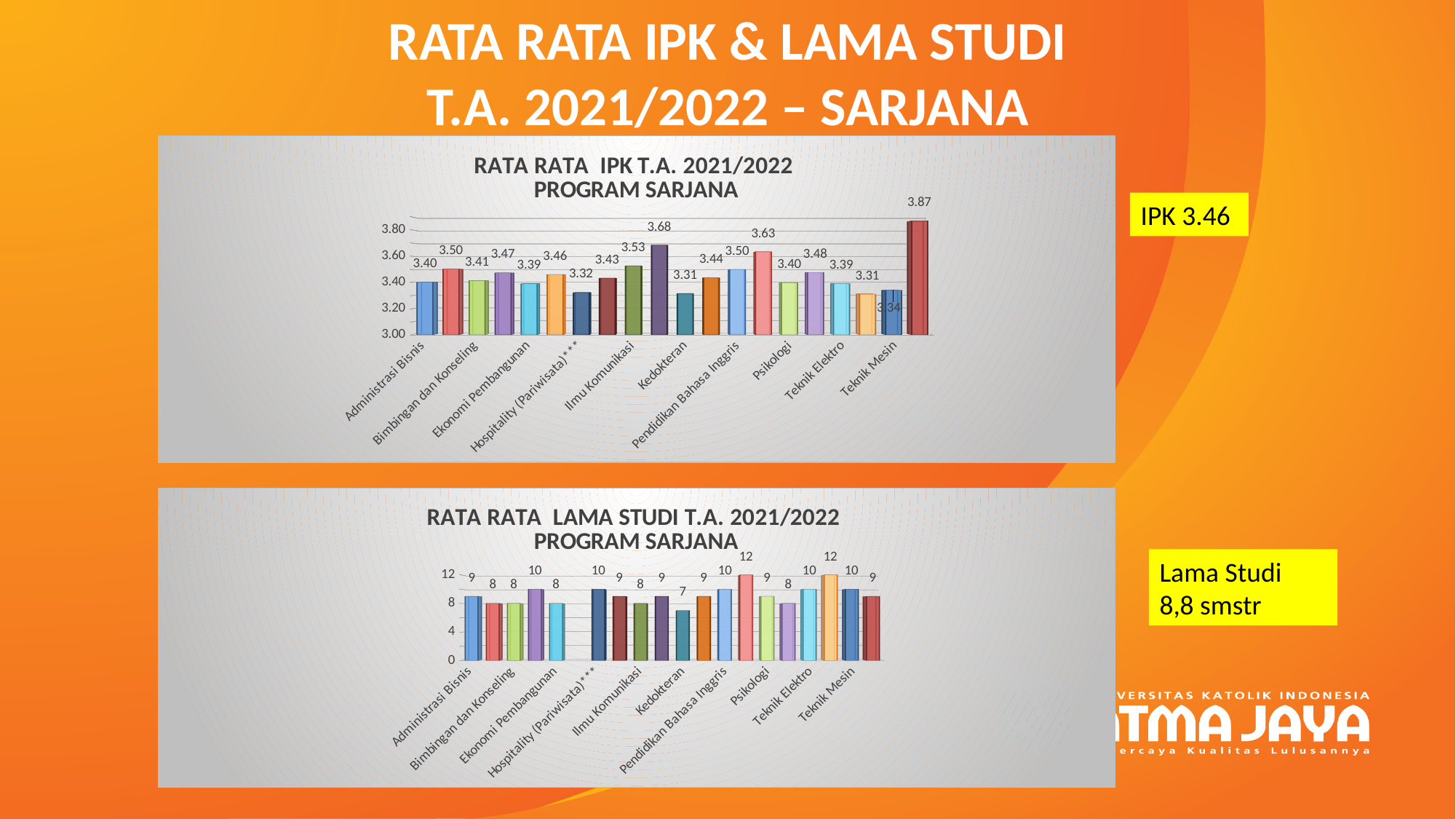
In the bottom chart (RATA RATA LAMA STUDI), what is the lowest value labelled on a bar? 7 In the top chart (RATA RATA IPK), what is the difference between the highest bar value (3.87) and the lowest bar value (3.31)? 0.56 What kind of chart is the top chart, 'RATA RATA IPK T.A. 2021/2022 PROGRAM SARJANA'? bar chart In the top chart (RATA RATA IPK), what is the lowest value shown on any bar? 3.31 In the bottom chart (RATA RATA LAMA STUDI), what is the highest value shown on any bar? 12 In the bottom chart (RATA RATA LAMA STUDI), what is the value of the first bar, labelled Administrasi Bisnis? 9 According to the yellow text box next to the top chart, what is the overall average IPK? IPK 3.46 In the top chart (RATA RATA IPK), what is the highest tick value shown on the vertical axis? 3.80 In the top chart (RATA RATA IPK), what is the highest value shown on any bar? 3.87 What kind of chart is the bottom chart, 'RATA RATA LAMA STUDI T.A. 2021/2022 PROGRAM SARJANA'? bar chart In the bottom chart (RATA RATA LAMA STUDI), is the value of the first bar (Administrasi Bisnis) greater or less than 8? greater In the top chart (RATA RATA IPK), what is the value of the first bar, labelled Administrasi Bisnis? 3.40